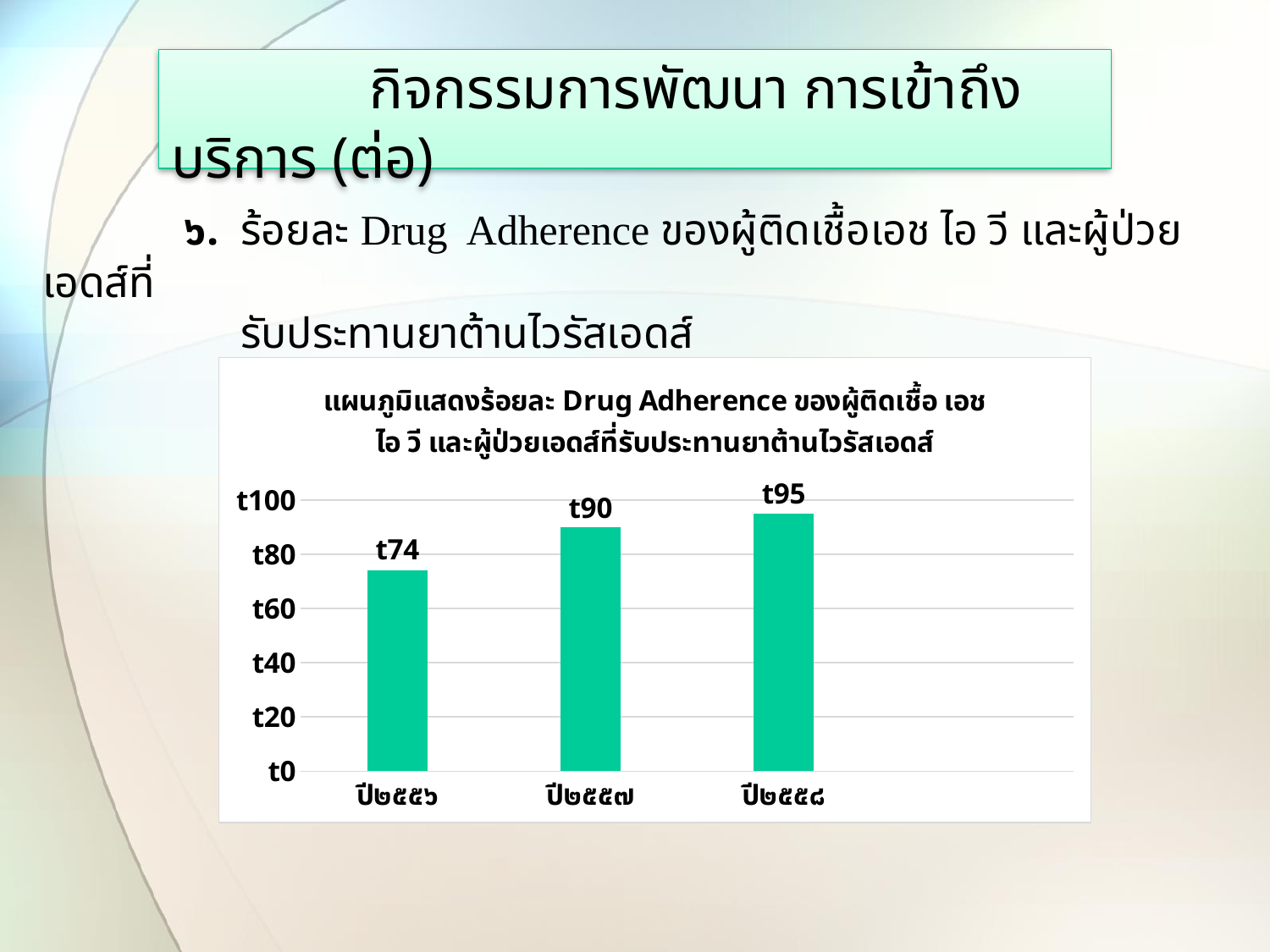
Which year has the lowest value? ปี๒๕๕๖ What kind of chart is shown? bar chart What is the difference between the values for ปี๒๕๕๘ and ปี๒๕๕๖? 21 What is the value for ปี๒๕๕๘? t95 What is the difference between the values for ปี๒๕๕๗ and ปี๒๕๕๖? 16 What is the value for ปี๒๕๕๖? t74 Which year has the highest value? ปี๒๕๕๘ What is the value for ปี๒๕๕๗? t90 Is the value for ปี๒๕๕๖ greater or less than 80? less Which is larger, the value for ปี๒๕๕๗ or ปี๒๕๕๘? ปี๒๕๕๘ Do the values rise or fall from ปี๒๕๕๖ to ปี๒๕๕๘? rise How many years are shown on the chart? 3